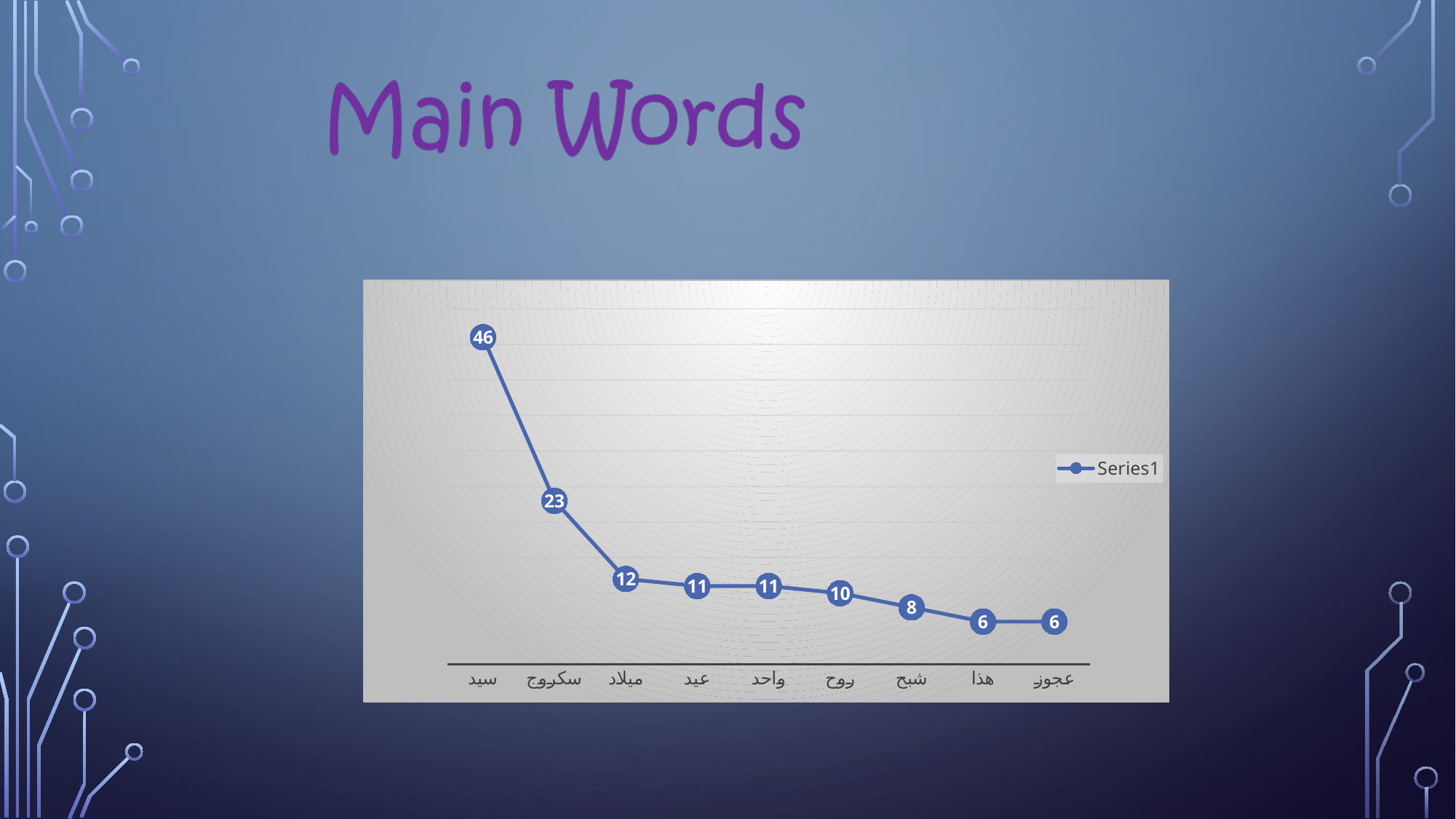
What is the value for روح? 10 How many categories are plotted on the x axis? 9 What is the difference between the values for سيد and سكروج? 23 Which category has the highest value? سيد Do the values rise or fall from left to right along the x axis? fall What is the value for سكروج? 23 What is the difference between the values for ميلاد and هذا? 6 Which is larger, the value for عيد or the value for شبح? عيد What is the value for سيد? 46 What kind of chart is shown on the slide? line chart What is the value for شبح? 8 How many series does the legend list? 1